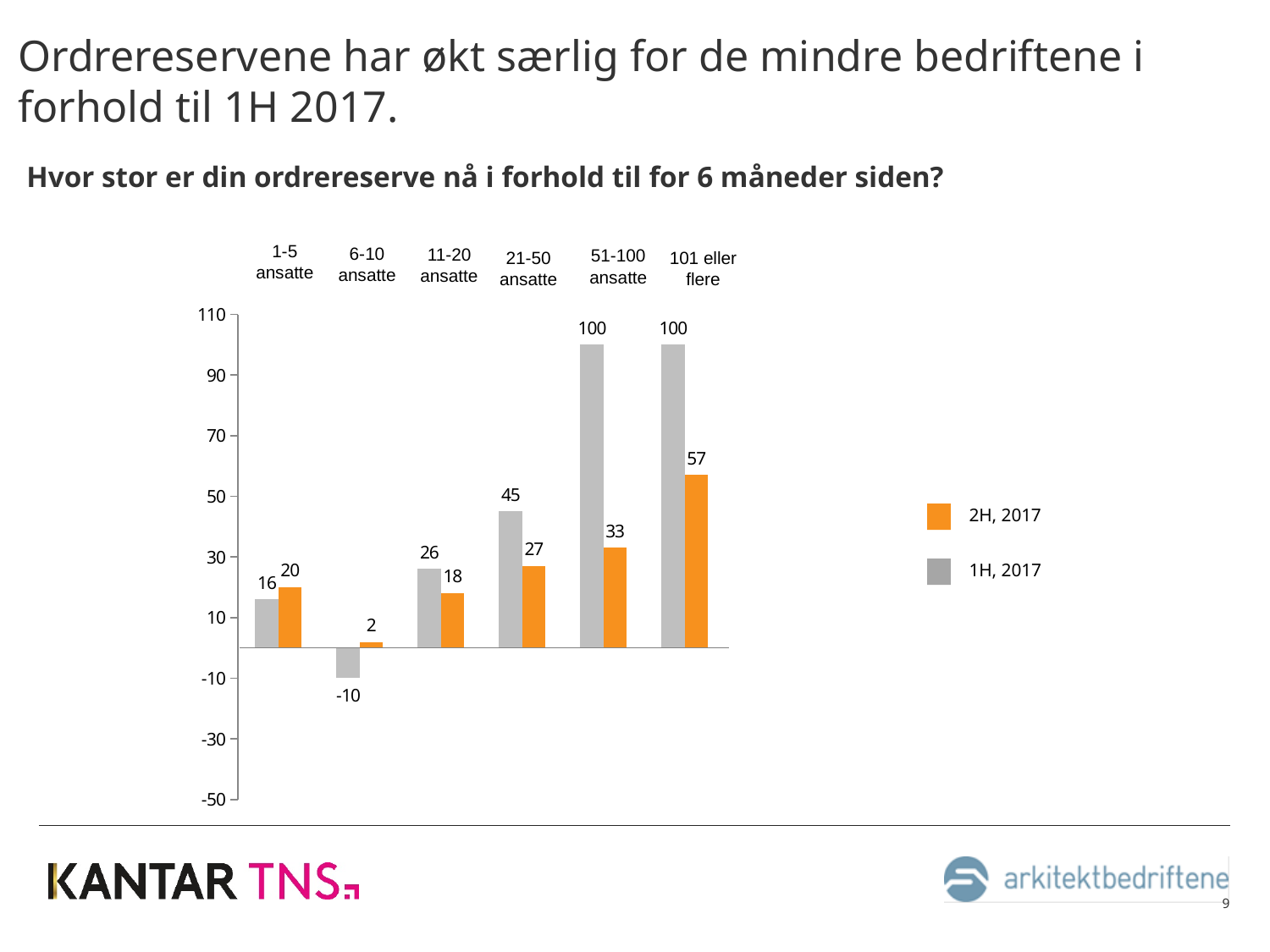
What is the difference between the 1H, 2017 and 2H, 2017 values for 51-100 ansatte? 67 Which category has the lowest value for 1H, 2017? 6-10 ansatte Which is larger for 1-5 ansatte: the 1H, 2017 value or the 2H, 2017 value? 2H, 2017 How many series does the legend list? 2 How many employee-size categories are shown on the x axis? 6 What is the value for 1H, 2017 for 21-50 ansatte? 45 What kind of chart is shown on the slide? Bar chart What is the value for 1H, 2017 for 6-10 ansatte? -10 Which colour represents 2H, 2017 in the chart? Orange Which category has the highest value for 2H, 2017? 101 eller flere What is the value for 2H, 2017 for 101 eller flere? 57 What is the value for 2H, 2017 for 51-100 ansatte? 33